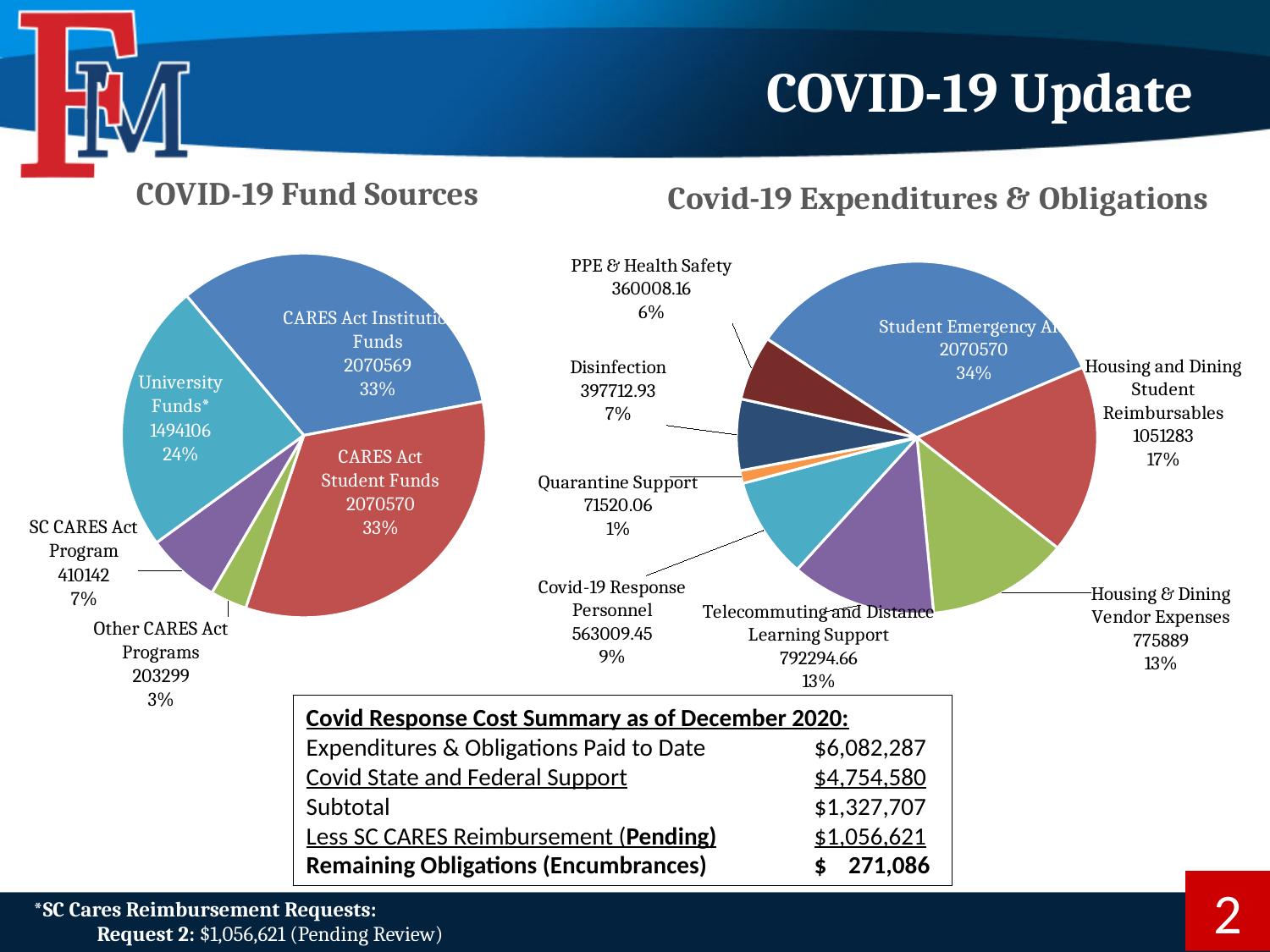
In the Covid-19 Expenditures & Obligations chart, which category has the largest slice? Student Emergency Aid In the COVID-19 Fund Sources chart, what percentage share does the SC CARES Act Program slice have? 7% In the COVID-19 Fund Sources chart, how many slices does the pie have? 5 In the COVID-19 Fund Sources chart, which category has the smallest slice? Other CARES Act Programs In the COVID-19 Fund Sources chart, what is the difference in percentage points between University Funds* (24%) and SC CARES Act Program (7%)? 17% In the Covid-19 Expenditures & Obligations chart, which is larger: Covid-19 Response Personnel or PPE & Health Safety? Covid-19 Response Personnel In the COVID-19 Fund Sources chart, what value is shown for University Funds*? 1494106 In the Covid-19 Expenditures & Obligations chart, what is the difference between Housing and Dining Student Reimbursables (1051283) and Housing & Dining Vendor Expenses (775889)? 275394 In the Covid-19 Expenditures & Obligations chart, what value is shown for Disinfection? 397712.93 In the Covid-19 Expenditures & Obligations chart, which category has the smallest slice? Quarantine Support What type of chart is used for Covid-19 Expenditures & Obligations? Pie chart In the Covid-19 Expenditures & Obligations chart, what percentage share does Telecommuting and Distance Learning Support have? 13%